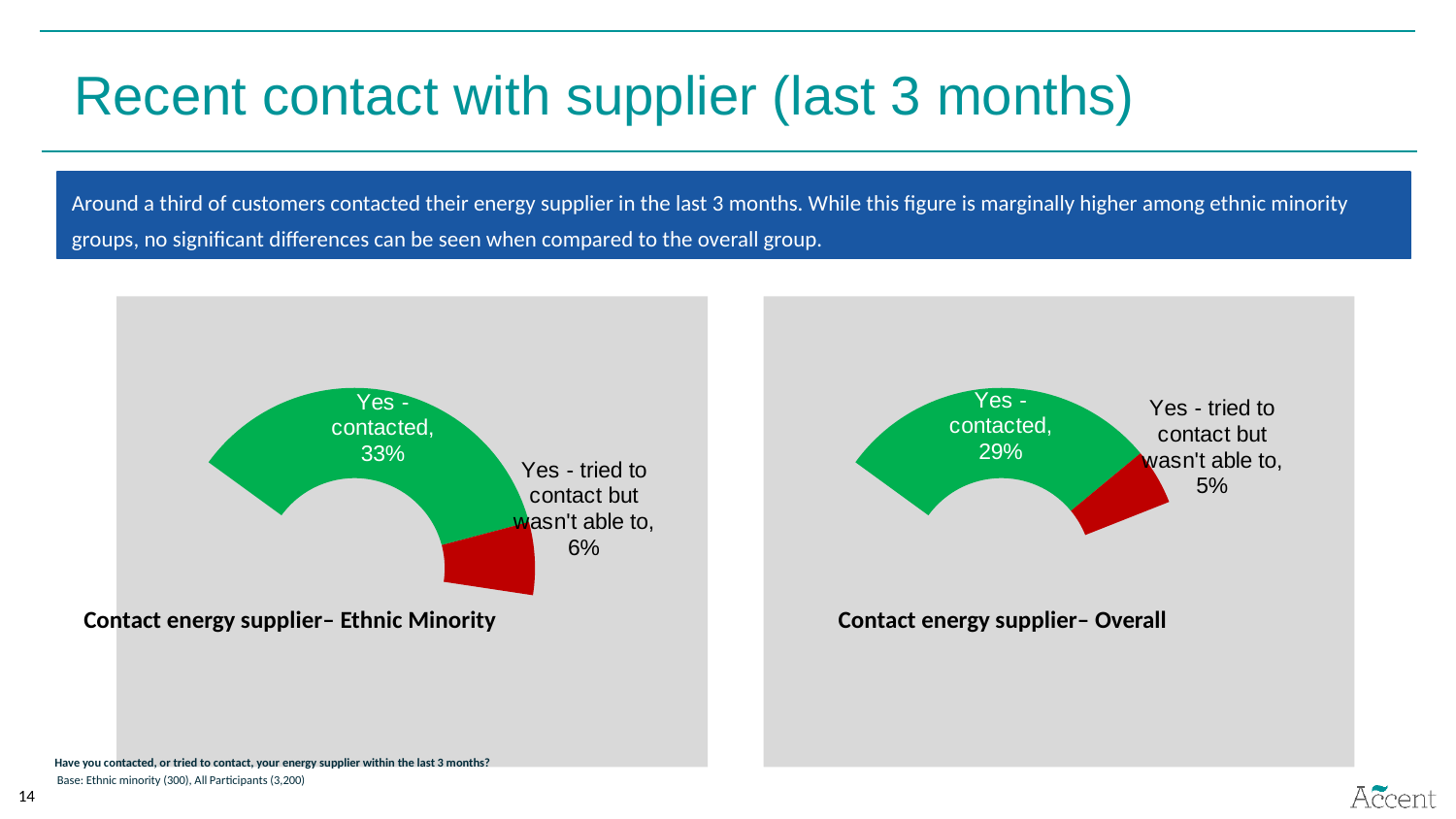
In the 'Contact energy supplier– Overall' chart, what percentage is shown for 'Yes - contacted'? 29% In the 'Contact energy supplier– Overall' chart, what colour is the 'Yes - contacted' segment? Green How many labelled categories are shown in the 'Contact energy supplier– Overall' chart? 2 In the 'Contact energy supplier– Ethnic Minority' chart, what percentage is shown for 'Yes - tried to contact but wasn't able to'? 6% In the 'Contact energy supplier– Ethnic Minority' chart, what percentage is shown for 'Yes - contacted'? 33% What type of chart is used in the 'Contact energy supplier– Ethnic Minority' panel? Doughnut chart In the 'Contact energy supplier– Overall' chart, what percentage is shown for 'Yes - tried to contact but wasn't able to'? 5% In the 'Contact energy supplier– Overall' chart, which category has the smaller value? Yes - tried to contact but wasn't able to In the 'Contact energy supplier– Ethnic Minority' chart, what is the difference between 'Yes - contacted' and 'Yes - tried to contact but wasn't able to'? 27 percentage points In the 'Contact energy supplier– Ethnic Minority' chart, which category has the larger value? Yes - contacted Is the 'Yes - tried to contact but wasn't able to' value larger in the Ethnic Minority chart or the Overall chart? Ethnic Minority What is the difference between the 'Yes - contacted' value in the Ethnic Minority chart and the 'Yes - contacted' value in the Overall chart? 4 percentage points